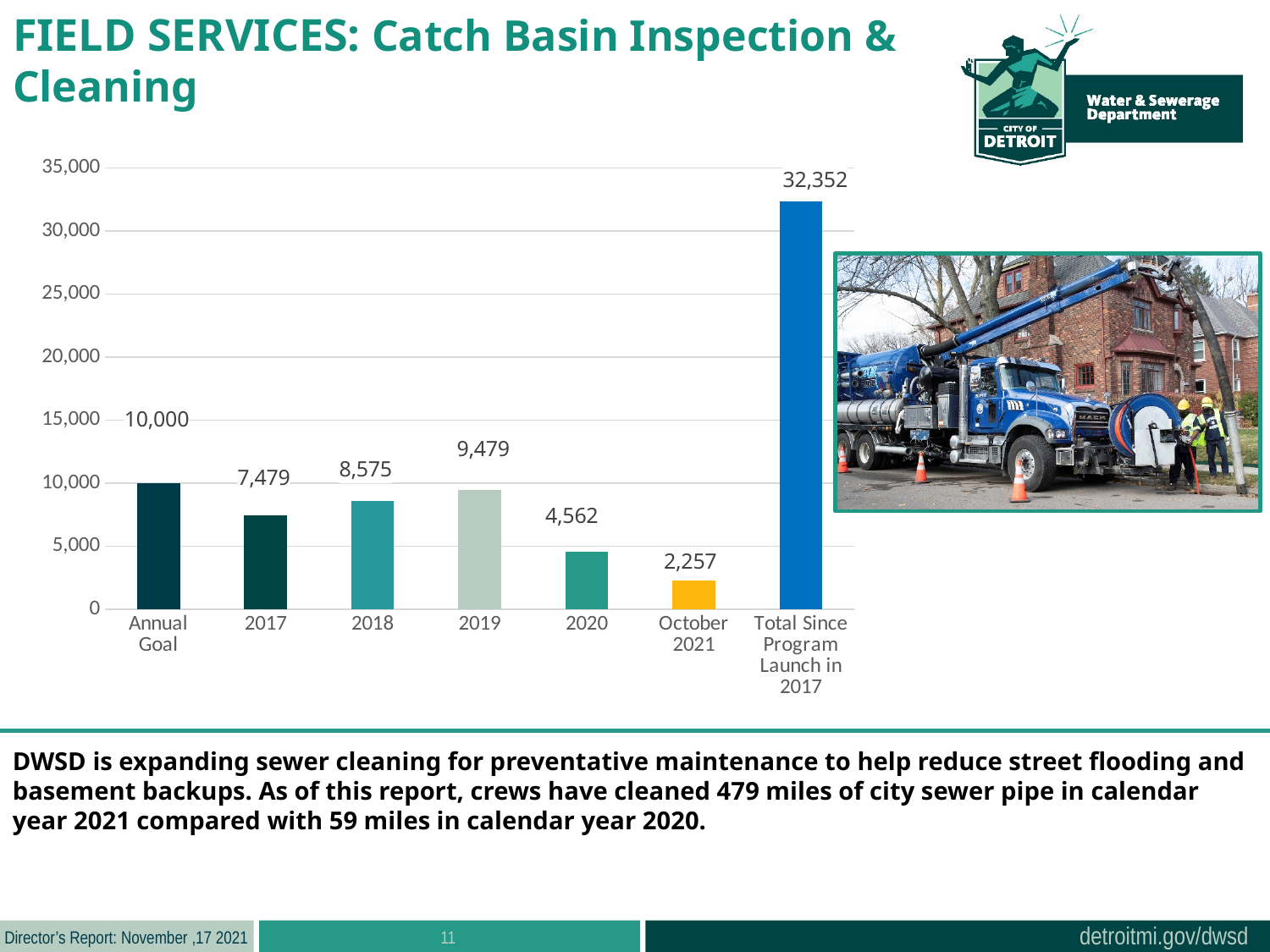
What is the difference between the 2019 and 2020 values? 4,917 Which category has the highest value? Total Since Program Launch in 2017 What kind of chart is shown on the slide? Bar chart Which category has the lowest value? October 2021 What is the value for October 2021? 2,257 Which is larger, the value for 2018 or the value for 2020? 2018 What is the difference between the 2018 and 2017 values? 1,096 How many bars are shown in the chart? 7 What is the value for 2019? 9,479 What is the value for Total Since Program Launch in 2017? 32,352 Do the values rise or fall from 2019 to 2020? Fall What is the value for the Annual Goal bar? 10,000